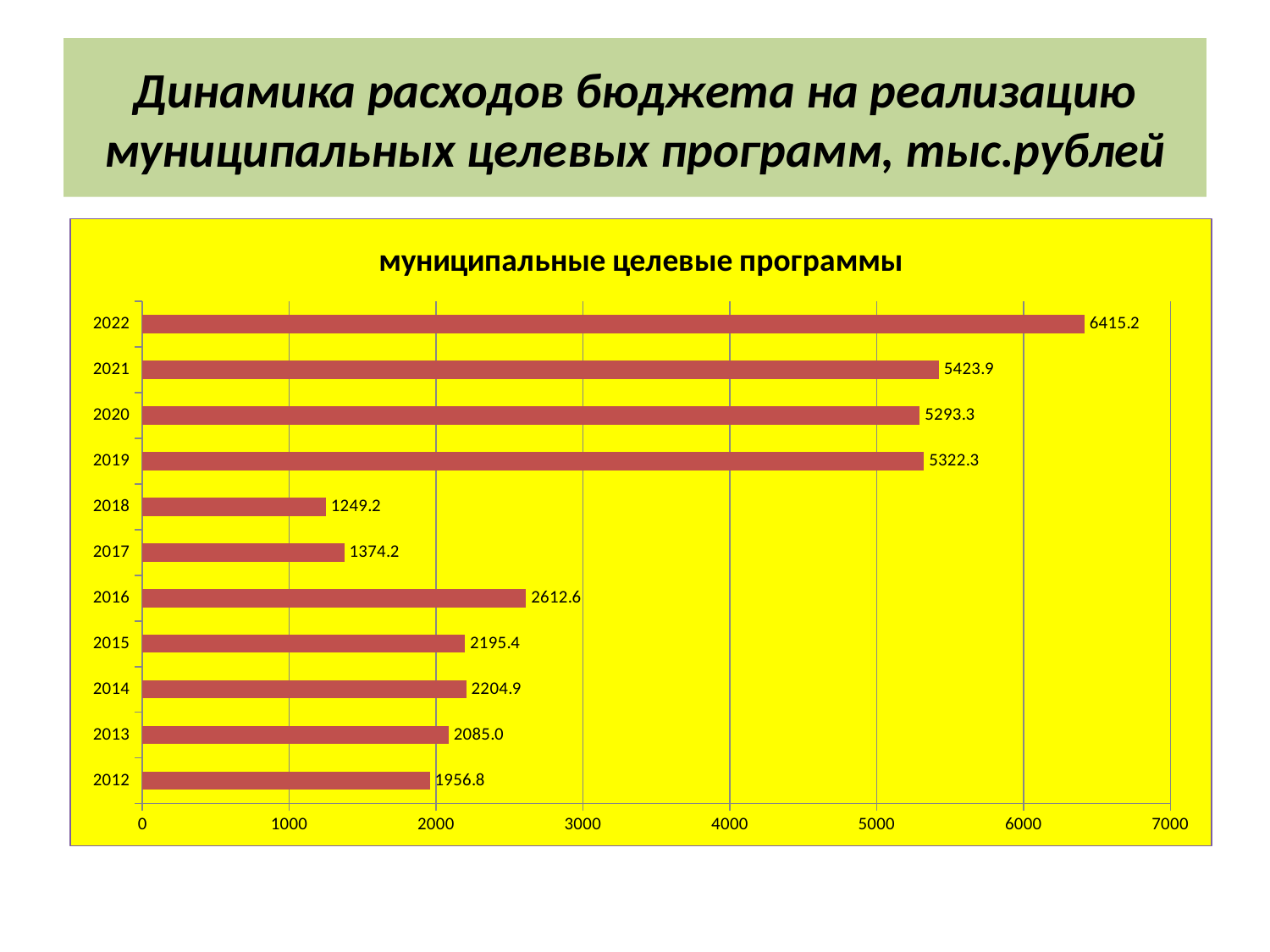
What is the value for 2022? 6415.2 Is the value for 2019 greater or less than 5000? greater Which is larger, the value for 2016 or the value for 2015? 2016 What is the difference between the values for 2017 and 2018? 125.0 What is the difference between the values for 2022 and 2021? 991.3 Which year has the lowest value? 2018 What is the value for 2018? 1249.2 How many years are shown on the chart? 11 What kind of chart is this? bar chart What is the title of the chart? муниципальные целевые программы What is the value for 2012? 1956.8 Which year has the highest value? 2022